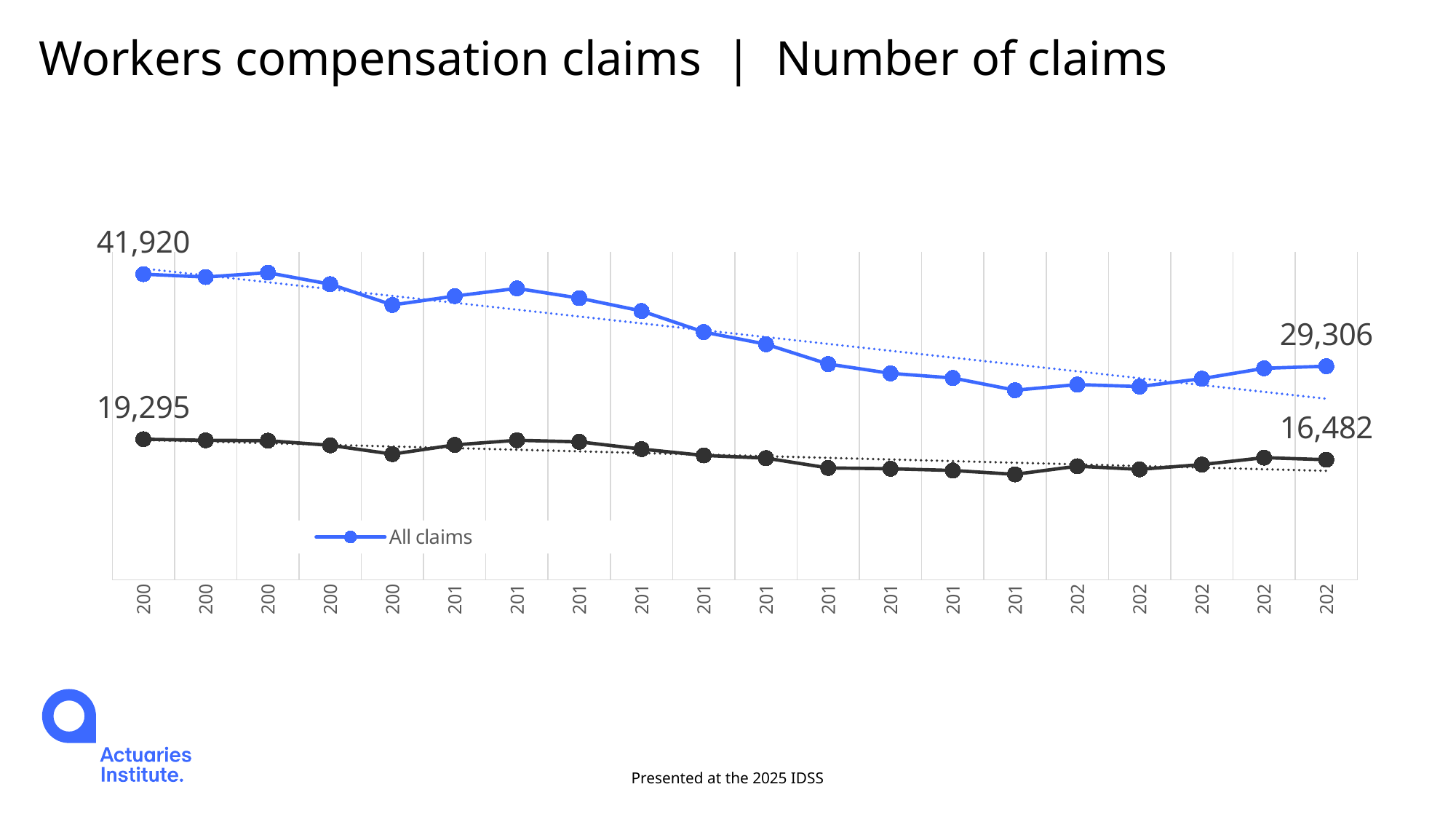
What is the difference between the first and last labelled values on the black line? 2,813 What is the title of the chart? Workers compensation claims | Number of claims How many data points does each line have? 20 What kind of chart is shown on the slide? line chart Which is larger for the All claims series: the first value or the last value? the first value What is the first (leftmost) value labelled on the black line? 19,295 What is the last (rightmost) value of the All claims series? 29,306 By how much did the All claims series fall from its first labelled value to its last labelled value? 12,614 Overall, does the All claims series rise or fall from left to right? fall What is the first (leftmost) value of the All claims series? 41,920 How many series does the legend list? 1 What is the last (rightmost) value labelled on the black line? 16,482